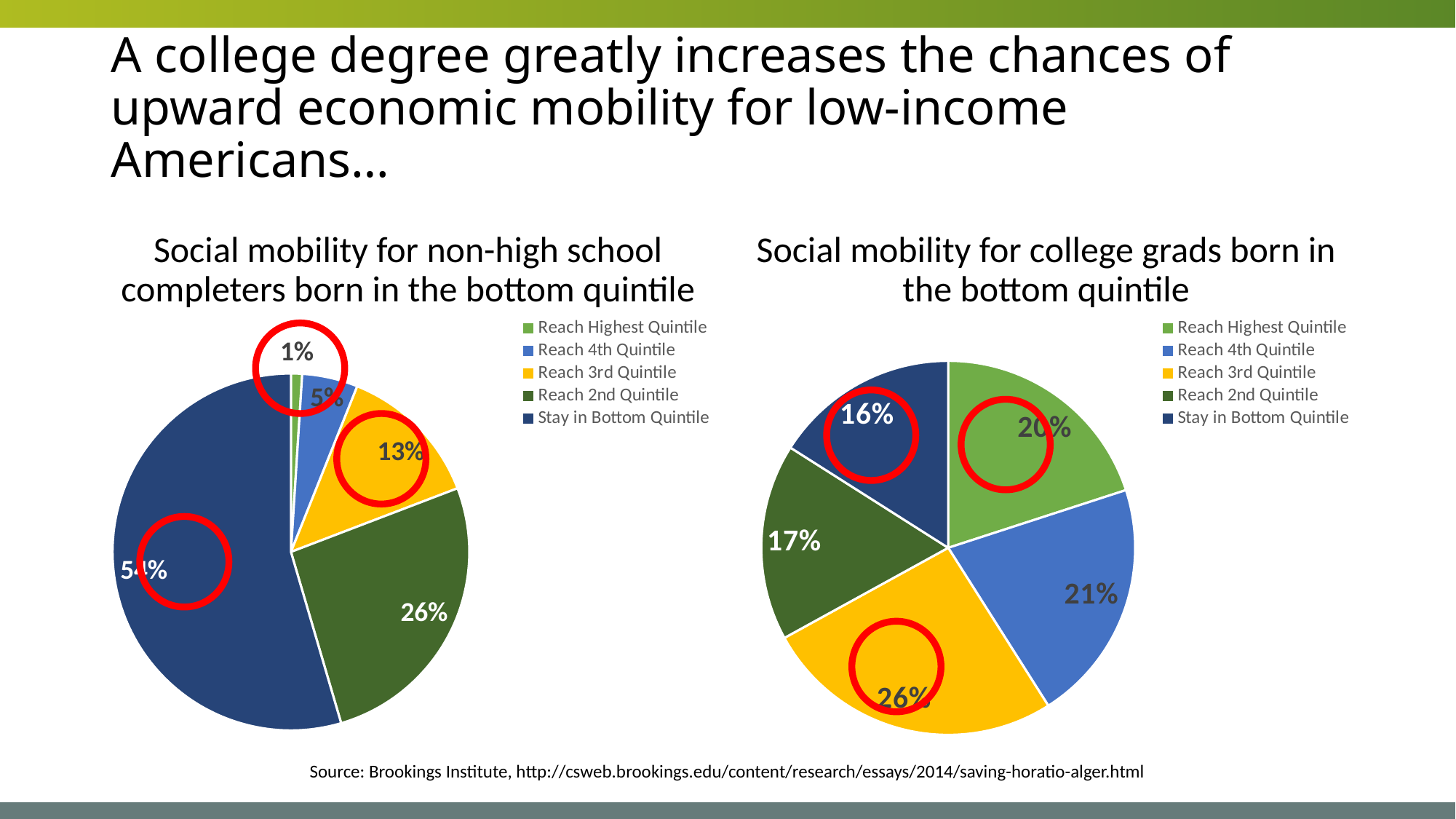
In the 'Social mobility for college grads born in the bottom quintile' chart, what percentage reach the highest quintile? 20% In the 'Social mobility for non-high school completers born in the bottom quintile' chart, what percentage reach the 3rd quintile? 13% In the 'Social mobility for non-high school completers born in the bottom quintile' chart, which category has the smallest share? Reach Highest Quintile What type of chart is used on this slide? Pie chart In the 'Social mobility for college grads born in the bottom quintile' chart, which category has the largest share? Reach 3rd Quintile In the 'Social mobility for non-high school completers born in the bottom quintile' chart, what percentage reach the highest quintile? 1% In the 'Social mobility for college grads born in the bottom quintile' chart, what percentage reach the 2nd quintile? 17% What is the difference between the 'Reach 2nd Quintile' share in the non-high school completers chart and the 'Reach 2nd Quintile' share in the college grads chart? 9% In the 'Social mobility for college grads born in the bottom quintile' chart, what percentage stay in the bottom quintile? 16% Which is larger: the 'Reach 4th Quintile' share in the college grads chart or the 'Reach 4th Quintile' share in the non-high school completers chart? College grads chart How many categories does the legend of the 'Social mobility for college grads born in the bottom quintile' chart list? 5 In the 'Social mobility for non-high school completers born in the bottom quintile' chart, which category has the largest share? Stay in Bottom Quintile